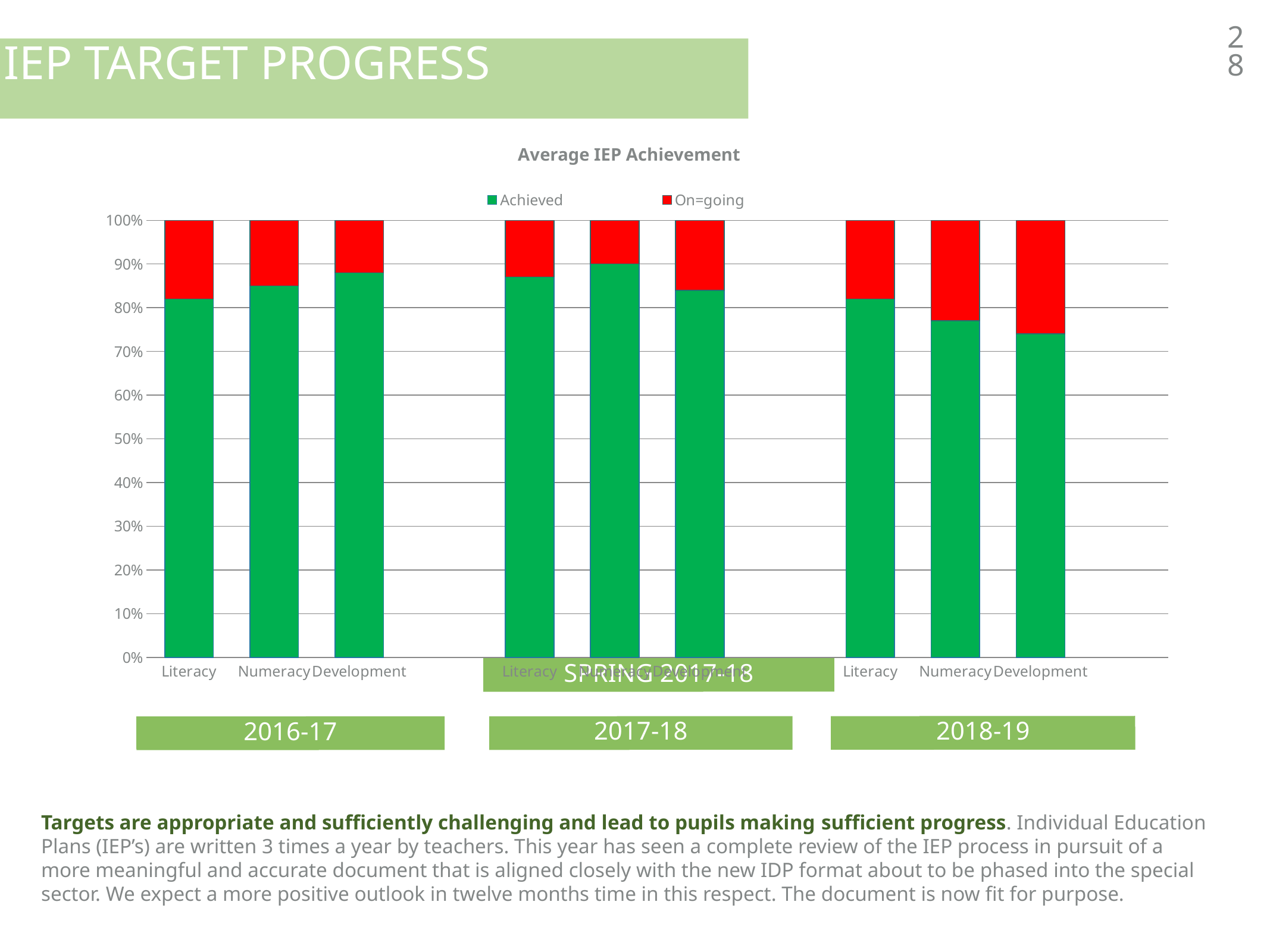
Is the Achieved value for Numeracy in 2018-19 greater or less than 80%? less Which has the larger Achieved share: Numeracy in 2017-18 or Development in 2018-19? Numeracy in 2017-18 Is the Achieved value for Development in 2018-19 greater or less than 80%? less Which colour represents the Achieved series? Green What is the title of the chart? Average IEP Achievement How many bars are plotted in the chart? 9 Which has the larger On=going share: Development in 2016-17 or Development in 2018-19? Development in 2018-19 Which bar has the lowest Achieved share? Development in 2018-19 Is the Achieved value for Development in 2016-17 greater or less than 80%? greater What kind of chart is shown on the slide? Stacked bar chart How many series does the chart legend list? 2